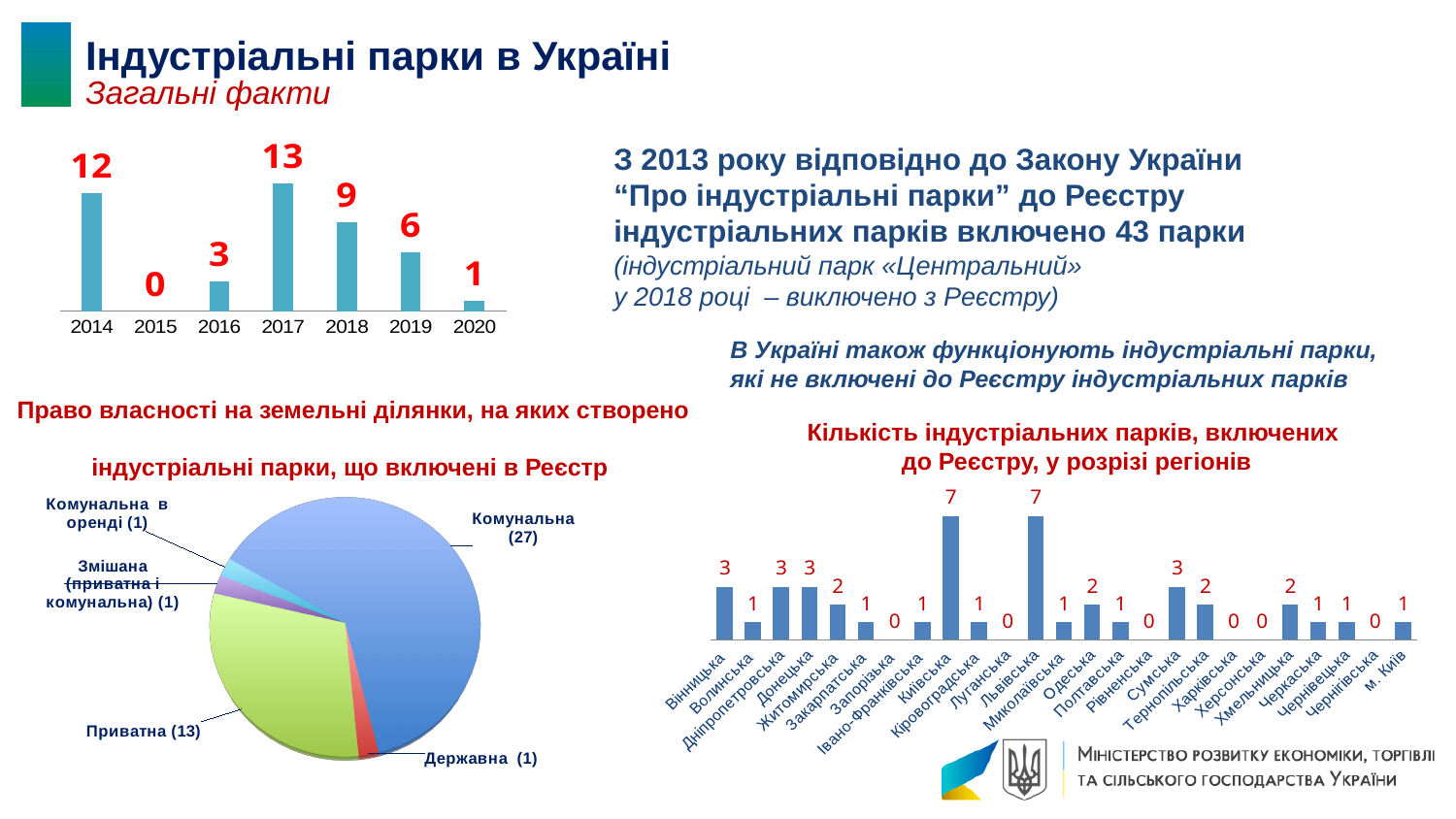
In the top-left bar chart of parks by year, what is the value for 2017? 13 In the chart of industrial parks by region, what is the value for Київська? 7 In the chart of industrial parks by region, which is larger, the value for Вінницька or the value for Волинська? Вінницька What type of chart is used to show ownership of land plots (Право власності на земельні ділянки)? pie chart In the top-left bar chart of parks by year, do the values rise or fall from 2017 to 2020? fall In the pie chart on ownership of land plots, which category has the largest slice? Комунальна (27) In the top-left bar chart of parks by year, what is the difference between the values for 2014 and 2018? 3 In the chart of industrial parks by region, how many regions are shown on the x axis? 25 In the top-left bar chart of parks by year, which year has the lowest value? 2015 In the pie chart on ownership of land plots, how many categories are shown? 5 In the pie chart on ownership of land plots, what is the value for Приватна? 13 In the top-left bar chart of parks by year, how many years are shown on the x axis? 7